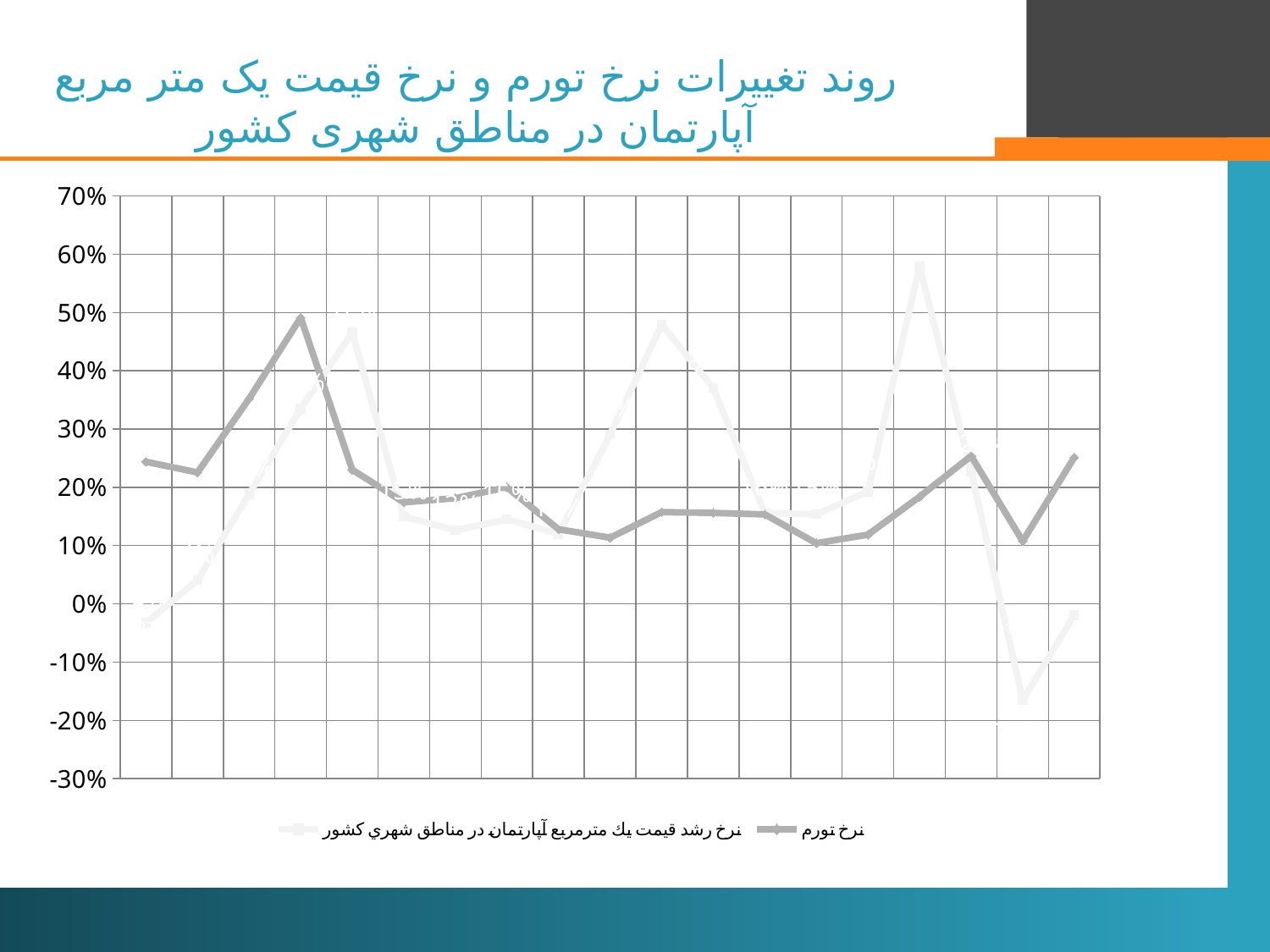
At the first point on the x axis, which series has the higher value? نرخ تورم At the last point on the x axis, which series has the higher value? نرخ تورم Is the highest value of the نرخ رشد قیمت یك مترمربع آپارتمان series greater or less than 50%? greater What kind of chart is shown on the slide? Line chart What is the title of the chart on the slide? روند تغییرات نرخ تورم و نرخ قیمت یک متر مربع آپارتمان در مناطق شهری کشور Is the lowest value of the نرخ رشد قیمت یك مترمربع آپارتمان series greater or less than -10%? less Is the lowest value of the نرخ تورم series greater or less than 0%? greater What are the two series named in the legend? نرخ تورم and نرخ رشد قیمت یك مترمربع آپارتمان در مناطق شهري كشور How many series does the legend list? 2 Which series reaches the higher peak value? نرخ رشد قیمت یك مترمربع آپارتمان در مناطق شهري كشور